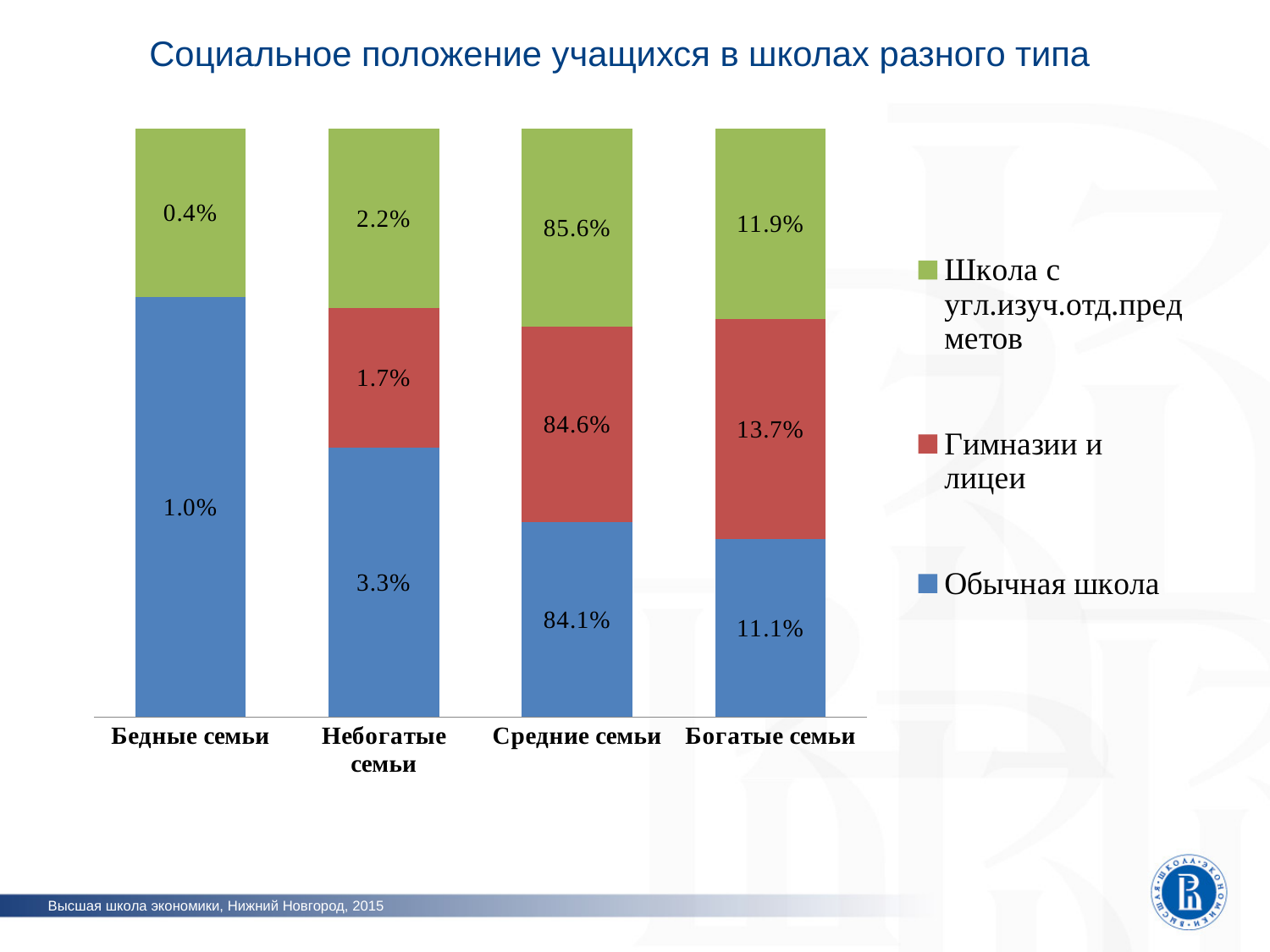
How many series does the legend list? 3 What is the value for Обычная школа in the Средние семьи category? 84.1% What is the value for Гимназии и лицеи in the Богатые семьи category? 13.7% What kind of chart is shown on the slide? Stacked bar chart What is the difference between the Гимназии и лицеи values for Средние семьи and Богатые семьи? 70.9% Which category has the lowest value for Школа с угл.изуч.отд.предметов? Бедные семьи Which category has the highest value for Гимназии и лицеи? Средние семьи How many family categories are shown on the x axis? 4 What is the difference between the Обычная школа values for Небогатые семьи and Бедные семьи? 2.3% What is the value for Школа с угл.изуч.отд.предметов in the Небогатые семьи category? 2.2% In the Богатые семьи category, which is larger: the value for Гимназии и лицеи or for Школа с угл.изуч.отд.предметов? Гимназии и лицеи What is the value for Обычная школа in the Бедные семьи category? 1.0%